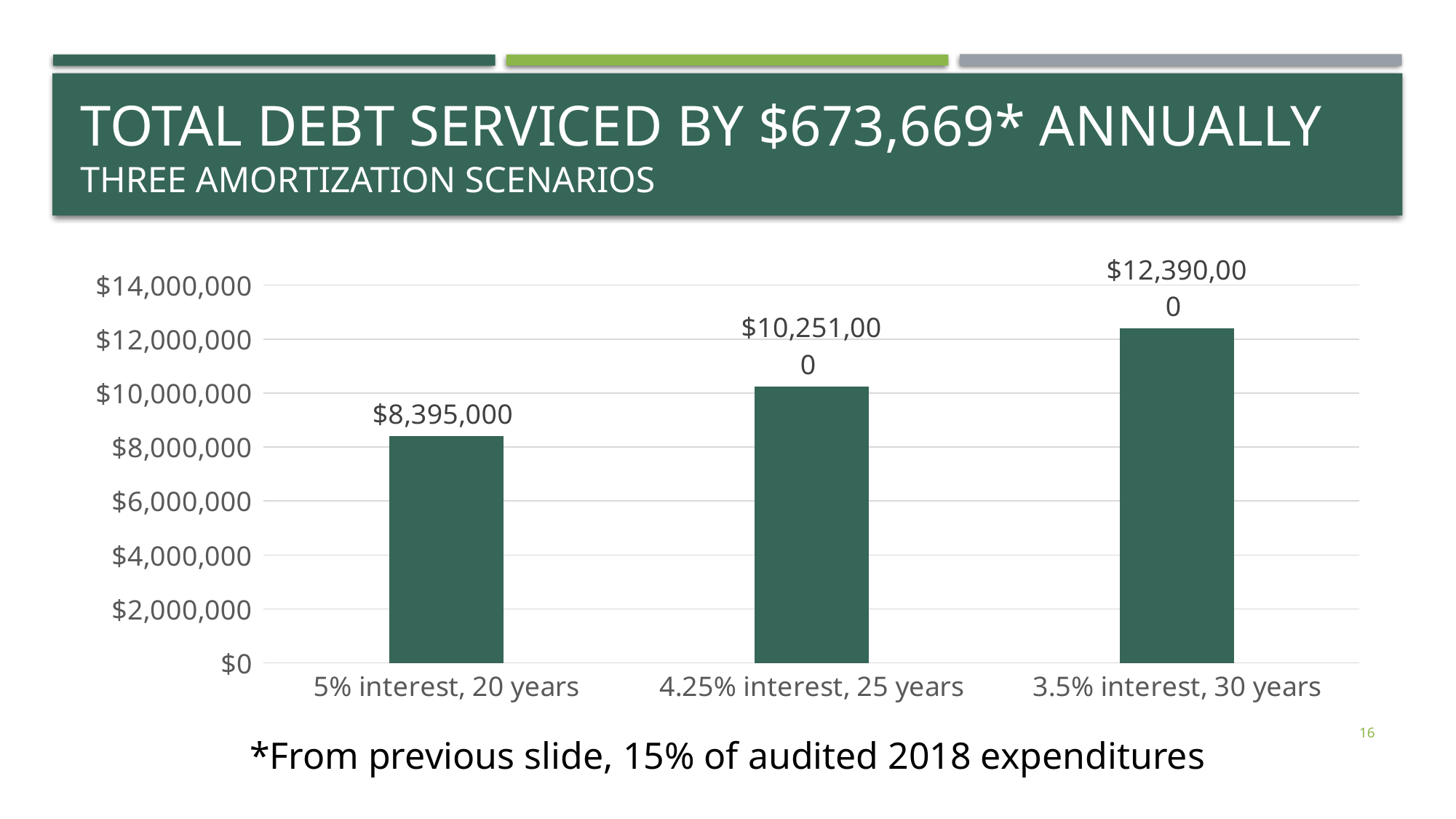
Which scenario has the highest total debt serviced? 3.5% interest, 30 years Is the value for 5% interest, 20 years greater or less than $10,000,000? less What is the value for the 4.25% interest, 25 years scenario? $10,251,000 What is the value for the 3.5% interest, 30 years scenario? $12,390,000 What kind of chart is shown on the slide? bar chart What is the value for the 5% interest, 20 years scenario? $8,395,000 Which is larger, the value for 4.25% interest, 25 years or the value for 3.5% interest, 30 years? 3.5% interest, 30 years Which scenario has the lowest total debt serviced? 5% interest, 20 years Do the values rise or fall from left to right across the scenarios? rise How many scenarios are shown in the chart? 3 What is the difference between the 3.5% interest, 30 years value and the 5% interest, 20 years value? $3,995,000 What is the difference between the 4.25% interest, 25 years value and the 5% interest, 20 years value? $1,856,000